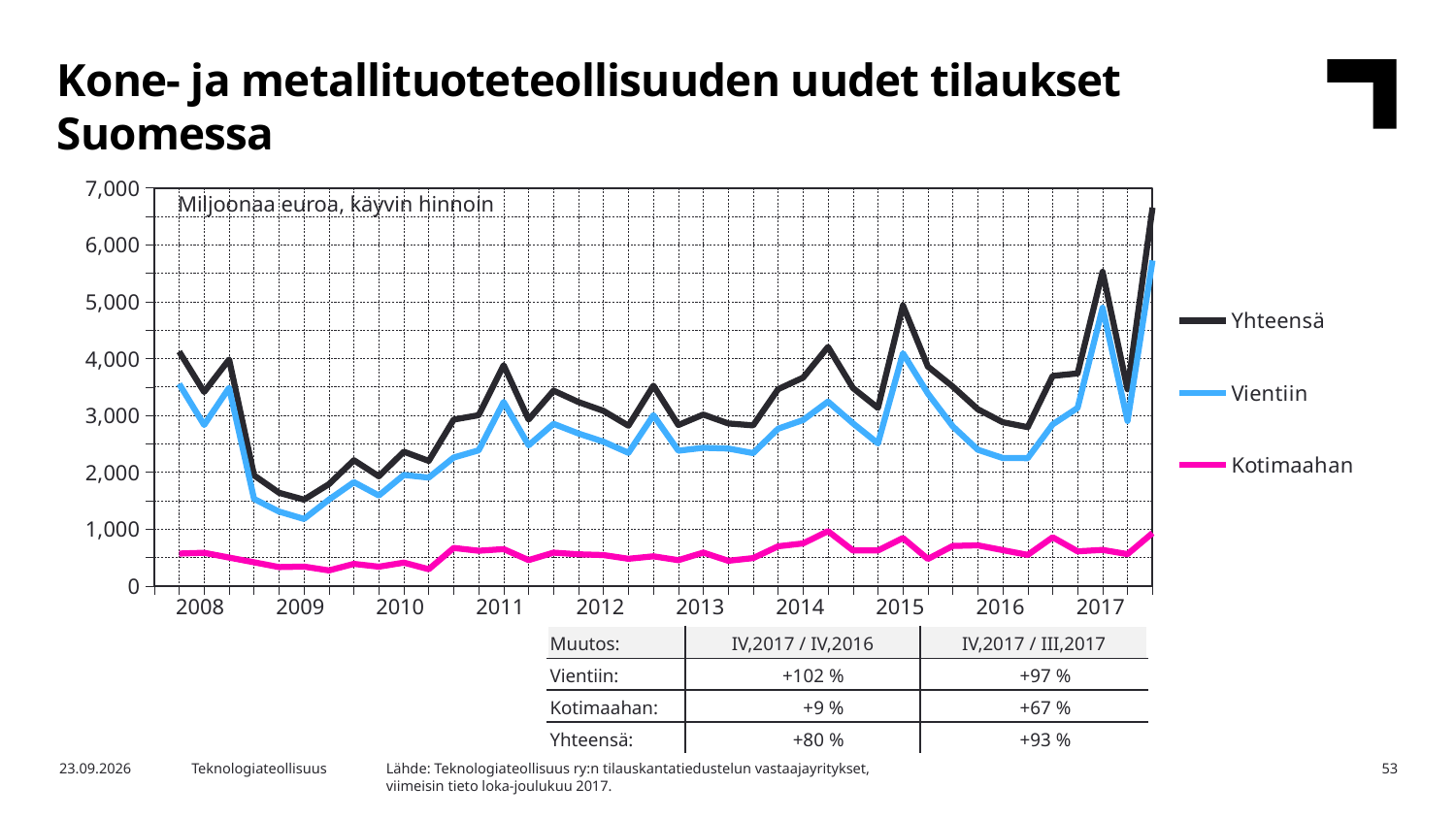
Does the Yhteensä line rise or fall from the start of 2016 to the end of 2017? rise How many year labels are shown on the x axis? 10 Which series has the highest values throughout the chart? Yhteensä What unit label is printed inside the chart area? Miljoonaa euroa, käyvin hinnoin Is the value for Kotimaahan at any point greater or less than 1,000? less Is the lowest value for Yhteensä in 2009 greater or less than 2,000? less Is the value for Vientiin at the last point of 2017 greater or less than 5,000? greater Which series has the lowest values throughout the chart? Kotimaahan What kind of chart is shown on the slide? Line chart What are the three series named in the legend? Yhteensä, Vientiin, Kotimaahan How many series does the legend list? 3